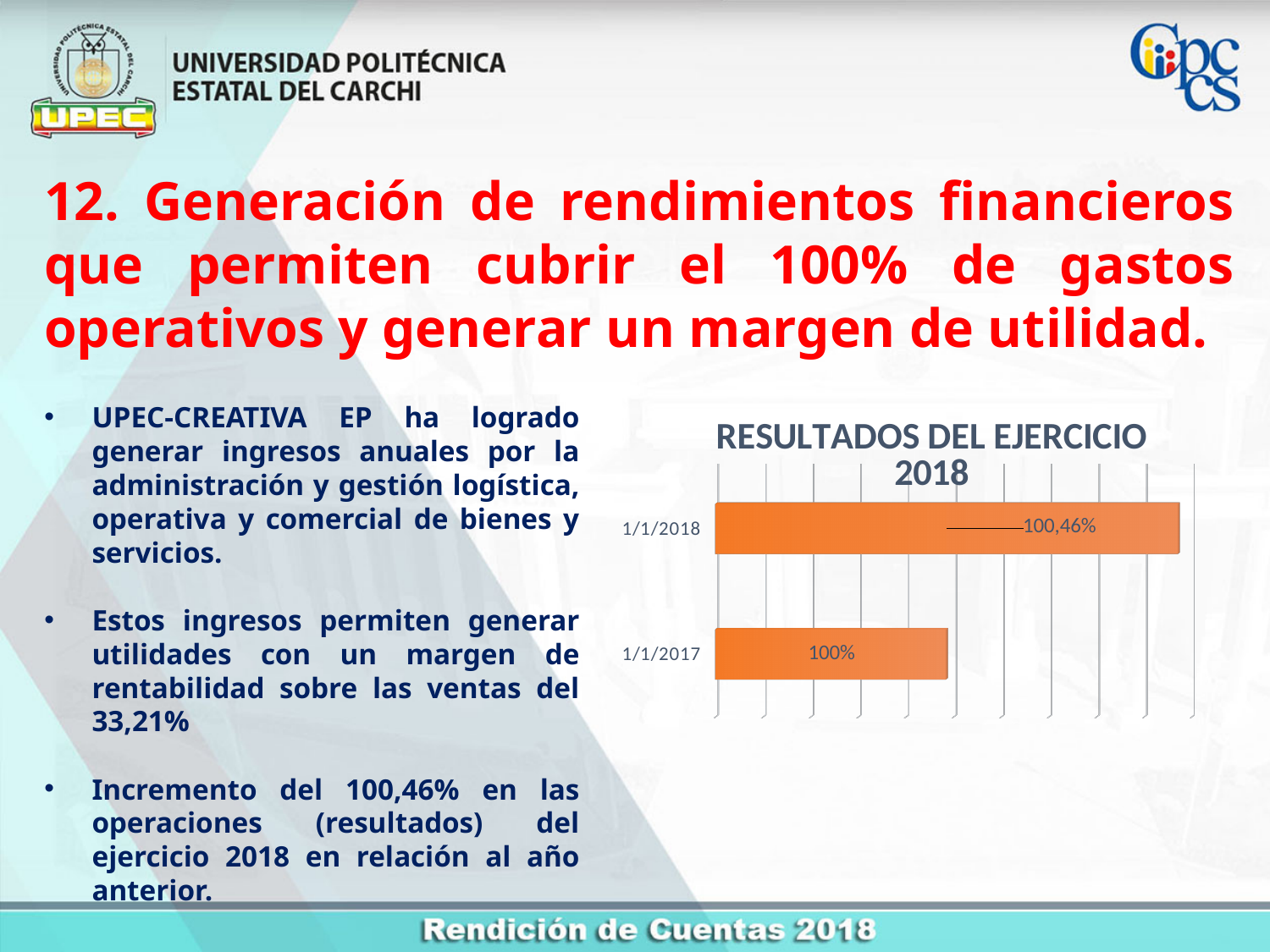
What is the title of the chart? RESULTADOS DEL EJERCICIO 2018 What is the value shown for 1/1/2018 in the chart? 100,46% Which category has the lowest value in the chart? 1/1/2017 What is the value shown for 1/1/2017 in the chart? 100% What kind of chart is shown on the slide? Bar chart What colour are the bars in the chart? Orange Which category has the highest value in the chart? 1/1/2018 How many categories are plotted in the chart? 2 Which is larger, the value for 1/1/2018 or the value for 1/1/2017? 1/1/2018